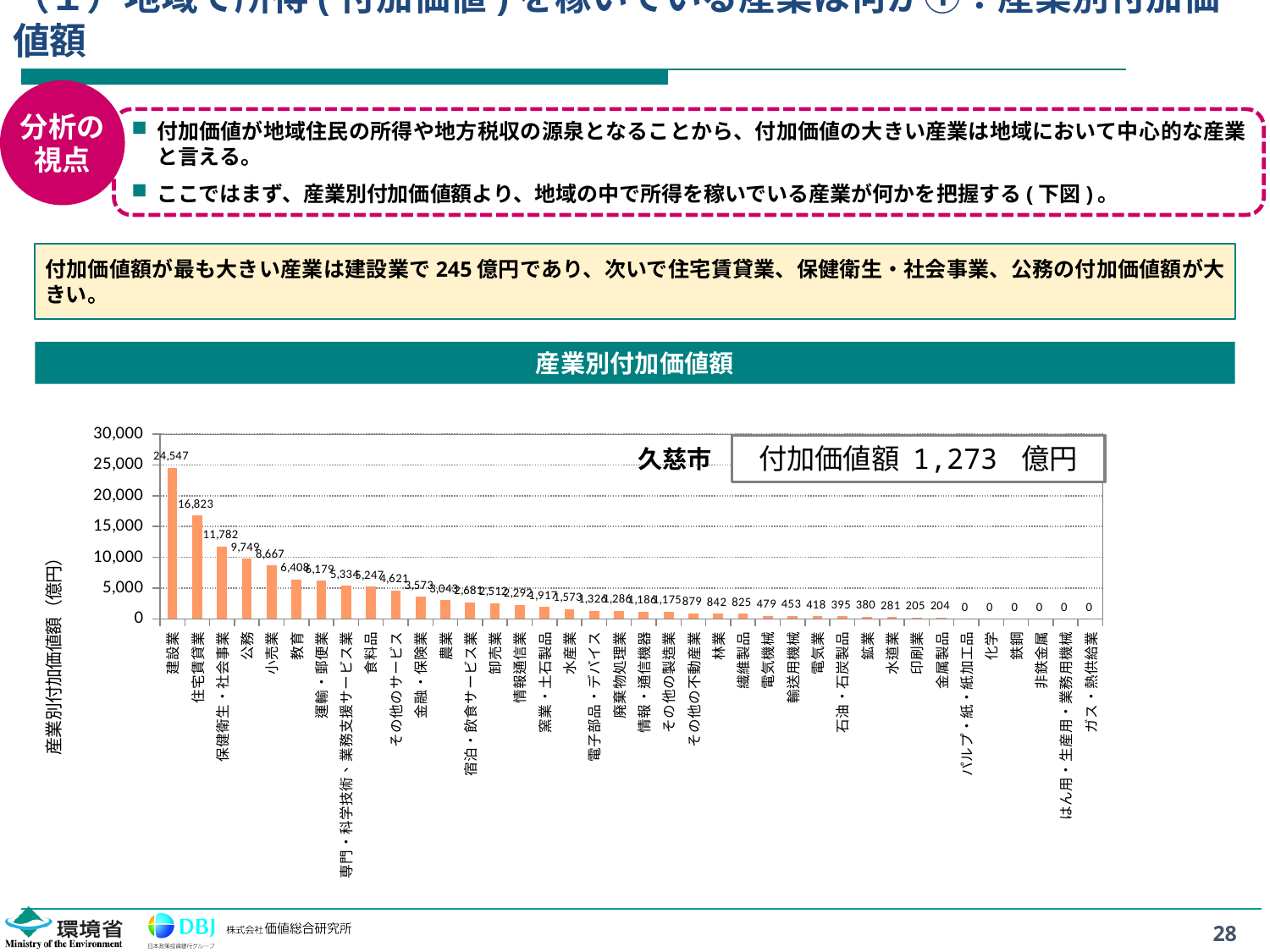
What is the value shown for 林業? 842 What is the value shown for 建設業? 24,547 What is the difference between the values for 建設業 and 住宅賃貸業? 7,724 Which industry has the highest value in the 産業別付加価値額 chart? 建設業 Which is larger, the value for 保健衛生・社会事業 or the value for 小売業? 保健衛生・社会事業 Is the value for 金融・保険業 greater or less than 5,000? less What is the difference between the values for 小売業 and 教育? 2,259 What is the value shown for 公務? 9,749 What kind of chart is used to show 産業別付加価値額? bar chart What is the value shown for 住宅賃貸業? 16,823 Do the values rise or fall moving from left to right along the x axis? fall How many industries in the chart have a value of 0? 6